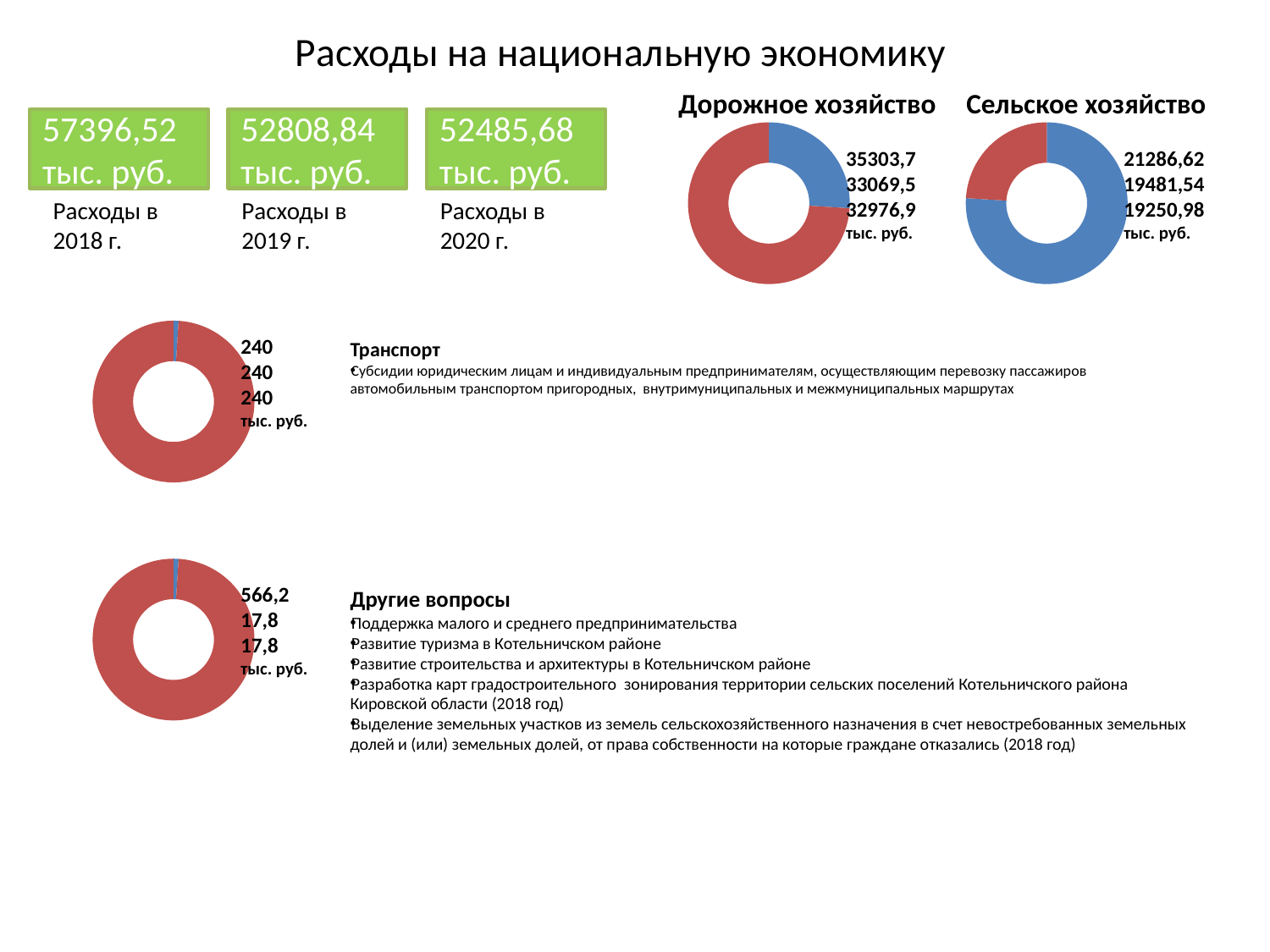
What is the smallest value printed on the "Сельское хозяйство" chart? 19250,98 What is the title of the doughnut chart in the top-right corner of the slide? Сельское хозяйство Which is larger: the largest value on the "Дорожное хозяйство" chart or the largest value on the "Сельское хозяйство" chart? Дорожное хозяйство What is the largest value printed on the "Дорожное хозяйство" chart? 35303,7 On the "Сельское хозяйство" chart, what is the difference between the largest printed value (21286,62) and the smallest printed value (19250,98)? 2035,64 What value is printed three times next to the "Транспорт" doughnut chart? 240 On the "Дорожное хозяйство" chart, what is the difference between the largest printed value (35303,7) and the smallest printed value (32976,9)? 2326,8 How many values are printed next to the "Транспорт" doughnut chart? 3 How many doughnut charts are shown on the slide? 4 What unit is printed under the values of the "Сельское хозяйство" chart? тыс. руб. What kind of chart is the "Дорожное хозяйство" chart? doughnut chart What is the largest value printed on the "Другие вопросы" chart? 566,2